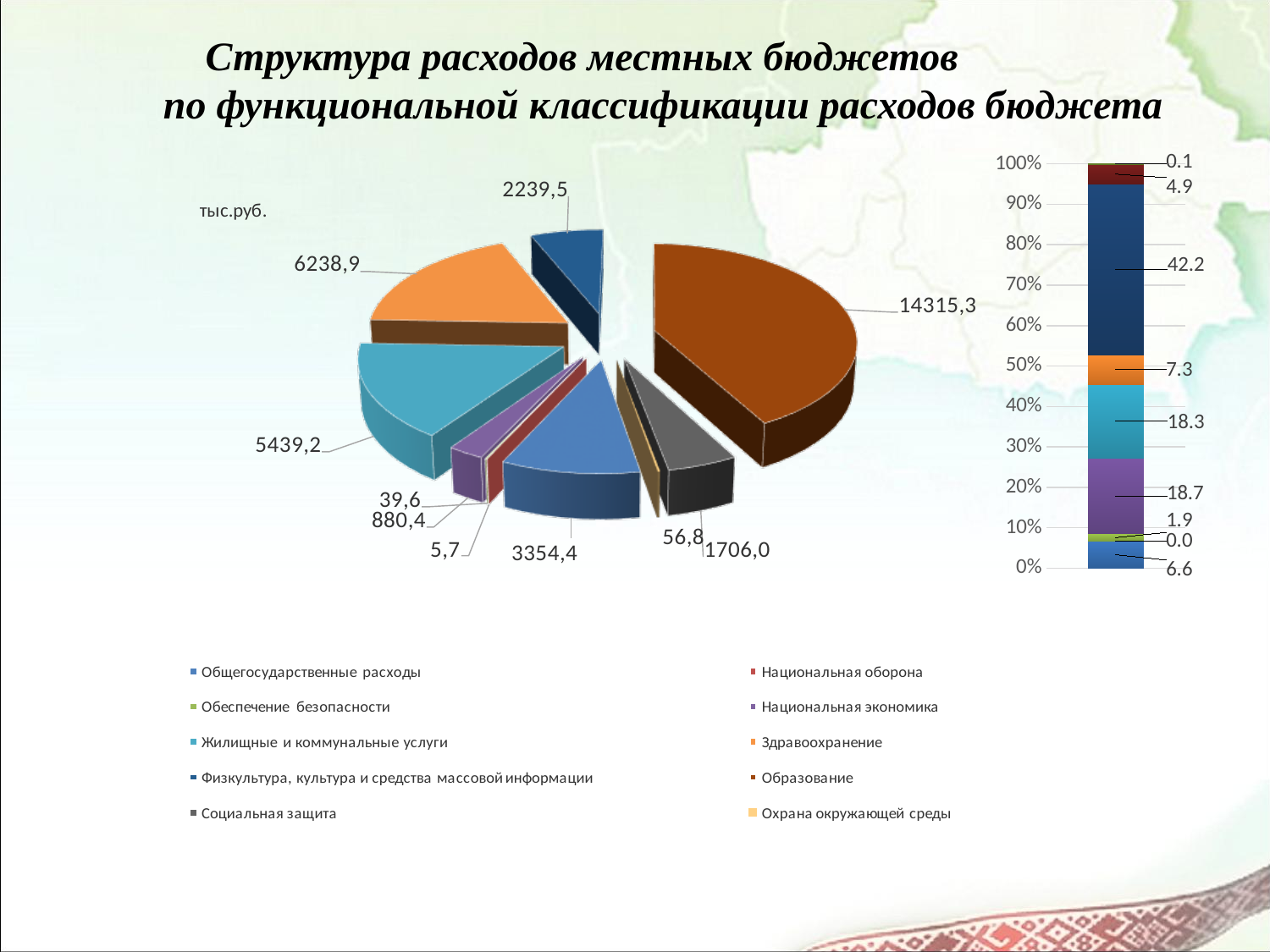
In the pie chart, what is the value for Жилищные и коммунальные услуги? 5439,2 What kind of chart is the chart on the right of the slide with the percentage axis? bar chart In the pie chart, what is the value of the largest slice? 14315,3 In the pie chart, what is the value for Образование? 14315,3 What kind of chart is the chart on the left of the slide? pie chart In the pie chart, what is the value of the smallest slice? 5,7 In the stacked bar chart on the right, what is the value of the largest segment? 42.2 How many categories does the legend list? 10 In the pie chart, what is the value for Здравоохранение? 6238,9 In the pie chart, which is larger: the slice labelled 3354,4 or the slice labelled 2239,5? 3354,4 In the pie chart, what is the difference between the values for Здравоохранение (6238,9) and Жилищные и коммунальные услуги (5439,2)? 799,7 What unit is shown next to the pie chart? тыс.руб.